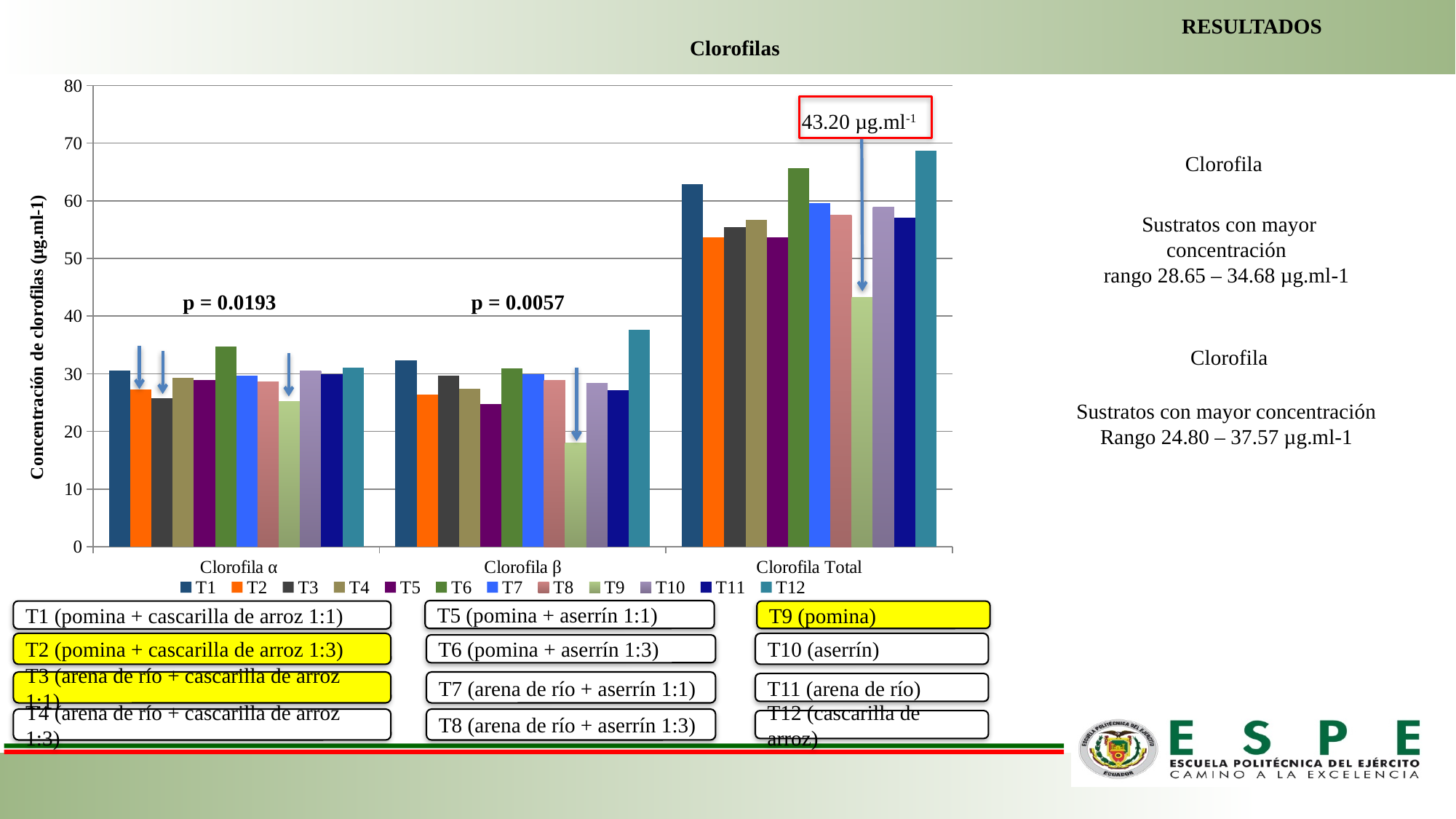
What value is labelled for T9 in the Clorofila Total category? 43.20 µg.ml-1 What is the title of the chart's vertical axis? Concentración de clorofilas (µg.ml-1) Which series has the lowest value in the Clorofila Total category? T9 How many series does the chart legend list? 12 In the Clorofila Total category, which is larger, the value for T6 or the value for T9? T6 Is the value for T12 in the Clorofila Total category greater or less than 60? greater Is the value for T9 in the Clorofila β category greater or less than 20? less What kind of chart is shown on the slide? bar chart Which series has the highest value in the Clorofila α category? T6 How many categories are shown on the x axis of the chart? 3 Which series has the highest value in the Clorofila β category? T12 Which series has the lowest value in the Clorofila β category? T9